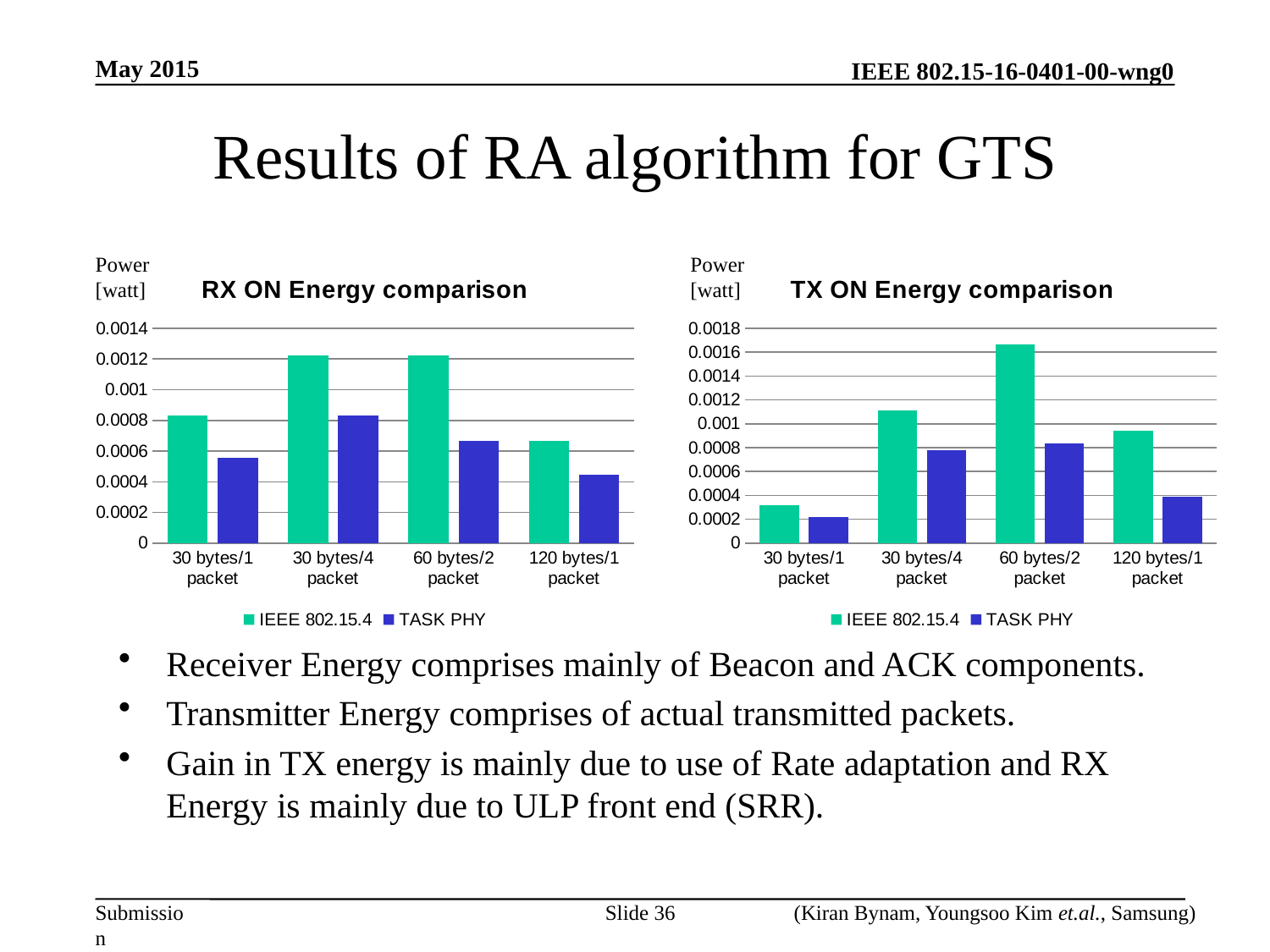
In the TX ON Energy comparison chart, is the IEEE 802.15.4 value for 60 bytes/2 packet greater or less than 0.0014? greater In the TX ON Energy comparison chart, which category has the highest IEEE 802.15.4 value? 60 bytes/2 packet What unit is shown on the y axis label of the TX ON Energy comparison chart? Power [watt] In the RX ON Energy comparison chart, for 60 bytes/2 packet, which series has the larger value, IEEE 802.15.4 or TASK PHY? IEEE 802.15.4 How many categories are shown on the x axis of the RX ON Energy comparison chart? 4 In the TX ON Energy comparison chart, is the IEEE 802.15.4 value for 30 bytes/1 packet greater or less than 0.0004? less In the RX ON Energy comparison chart, which category has the lowest TASK PHY value? 120 bytes/1 packet In the RX ON Energy comparison chart, is the IEEE 802.15.4 value for 30 bytes/4 packet greater or less than 0.001? greater In the RX ON Energy comparison chart, which category has the highest TASK PHY value? 30 bytes/4 packet How many series does the legend of the TX ON Energy comparison chart list? 2 What type of chart is the RX ON Energy comparison chart? bar chart In the TX ON Energy comparison chart, which category has the lowest IEEE 802.15.4 value? 30 bytes/1 packet